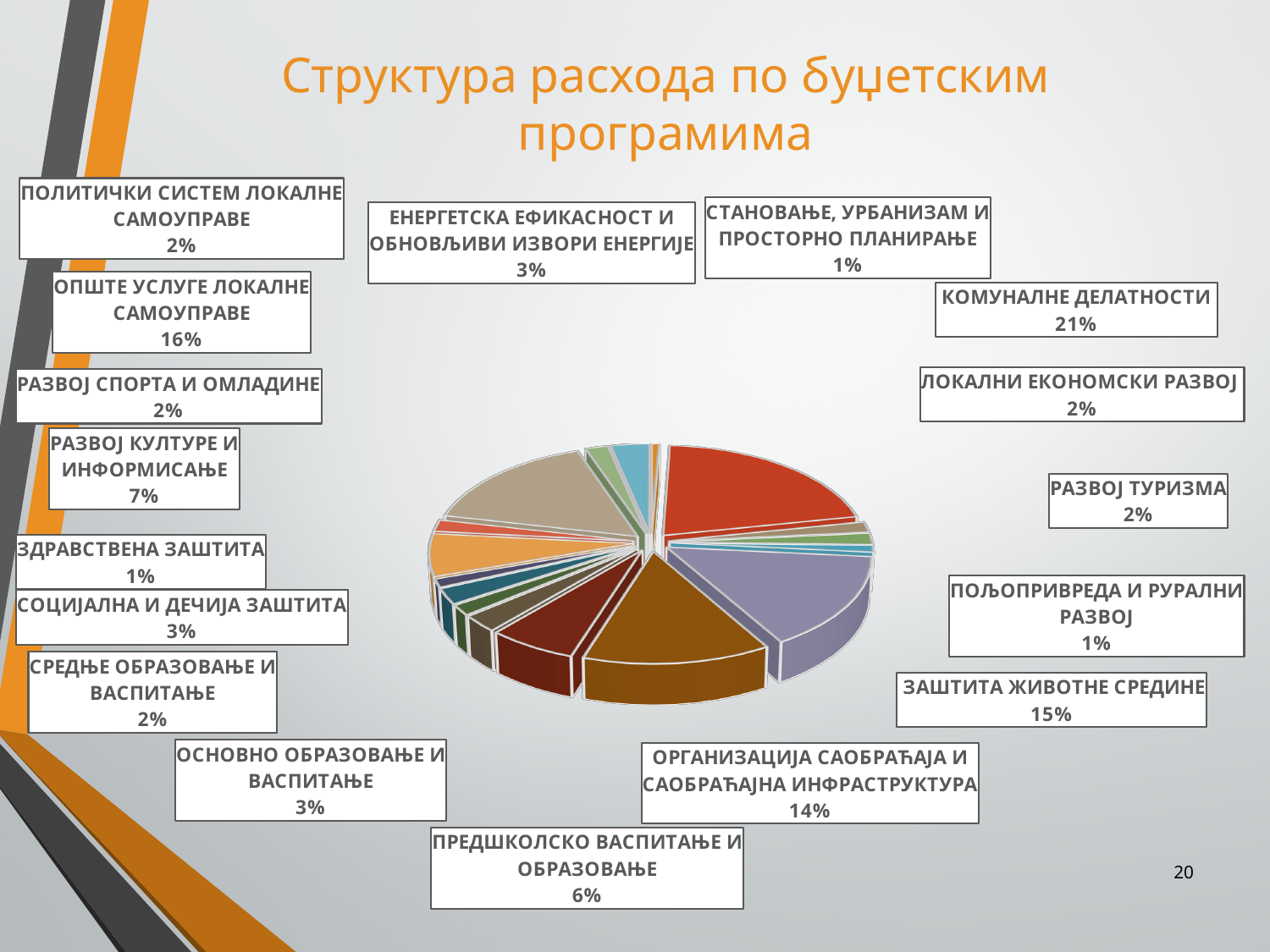
Which budget programme has the largest share of expenditure? КОМУНАЛНЕ ДЕЛАТНОСТИ How many budget programmes are shown in the pie chart? 17 What share of expenditure goes to КОМУНАЛНЕ ДЕЛАТНОСТИ? 21% What share of the pie does ОРГАНИЗАЦИЈА САОБРАЋАЈА И САОБРАЋАЈНА ИНФРАСТРУКТУРА represent? 14% What share of expenditure goes to РАЗВОЈ КУЛТУРЕ И ИНФОРМИСАЊЕ? 7% What share of expenditure goes to ЗАШТИТА ЖИВОТНЕ СРЕДИНЕ? 15% What is the difference in percentage points between КОМУНАЛНЕ ДЕЛАТНОСТИ and ЗАШТИТА ЖИВОТНЕ СРЕДИНЕ? 6 Which has a larger share: ОПШТЕ УСЛУГЕ ЛОКАЛНЕ САМОУПРАВЕ or ОРГАНИЗАЦИЈА САОБРАЋАЈА И САОБРАЋАЈНА ИНФРАСТРУКТУРА? ОПШТЕ УСЛУГЕ ЛОКАЛНЕ САМОУПРАВЕ What is the title of the chart on the slide? Структура расхода по буџетским програмима What kind of chart is shown on the slide? Pie chart What share of expenditure goes to ОПШТЕ УСЛУГЕ ЛОКАЛНЕ САМОУПРАВЕ? 16% What share of expenditure goes to ПРЕДШКОЛСКО ВАСПИТАЊЕ И ОБРАЗОВАЊЕ? 6%